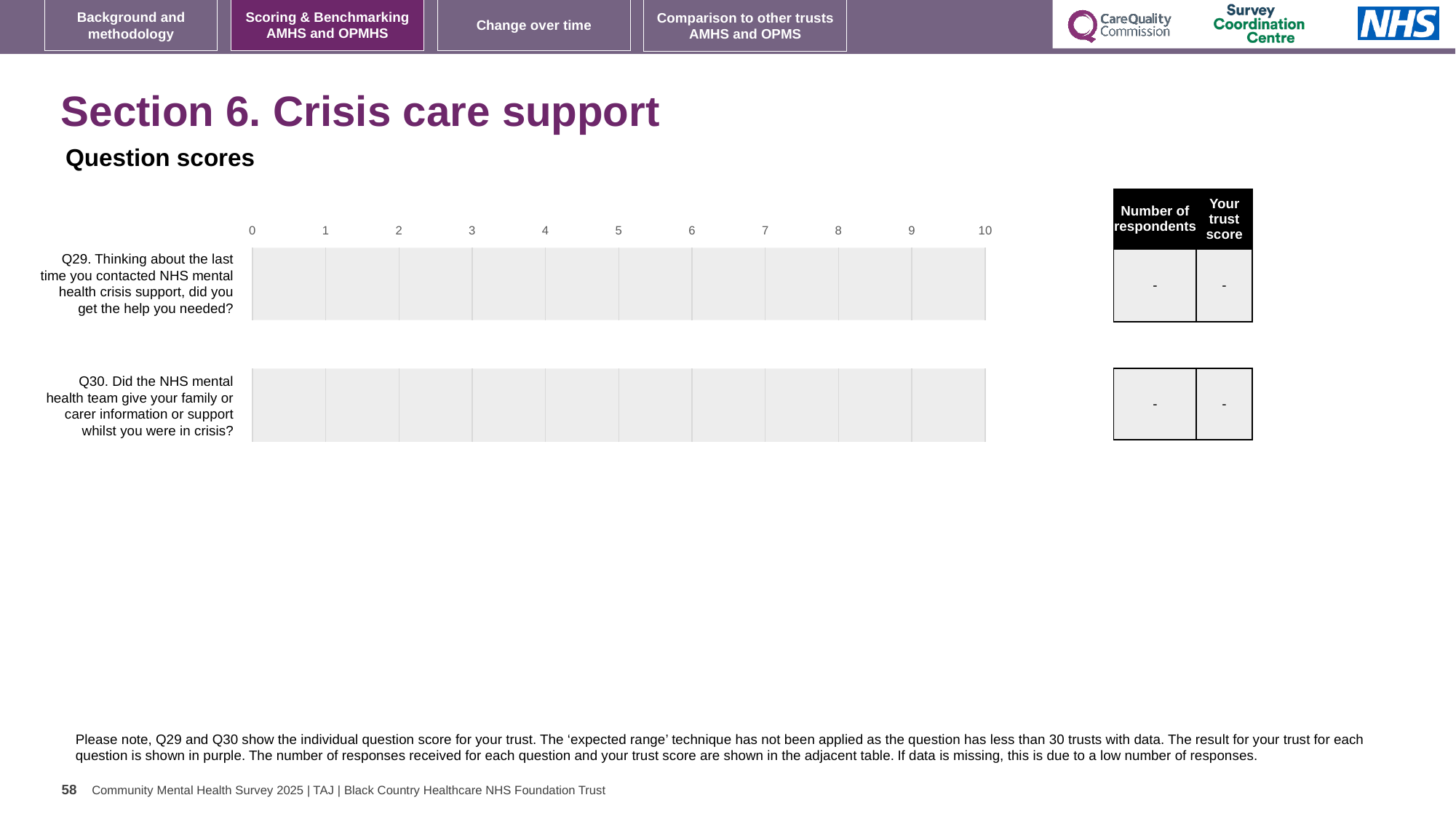
How many questions (categories) are listed on the chart? 2 What is shown in the 'Number of respondents' column for Q29 in the adjacent table? - Which question number is listed second on the chart? Q30 Are any bar values plotted for Q29 or Q30 on the chart? No Which question number is listed first (at the top) on the chart? Q29 What is the highest value shown on the chart's horizontal axis? 10 What kind of chart is shown on the slide? bar chart What is shown in the 'Your trust score' column for Q30 in the adjacent table? - What is the lowest value shown on the chart's horizontal axis? 0